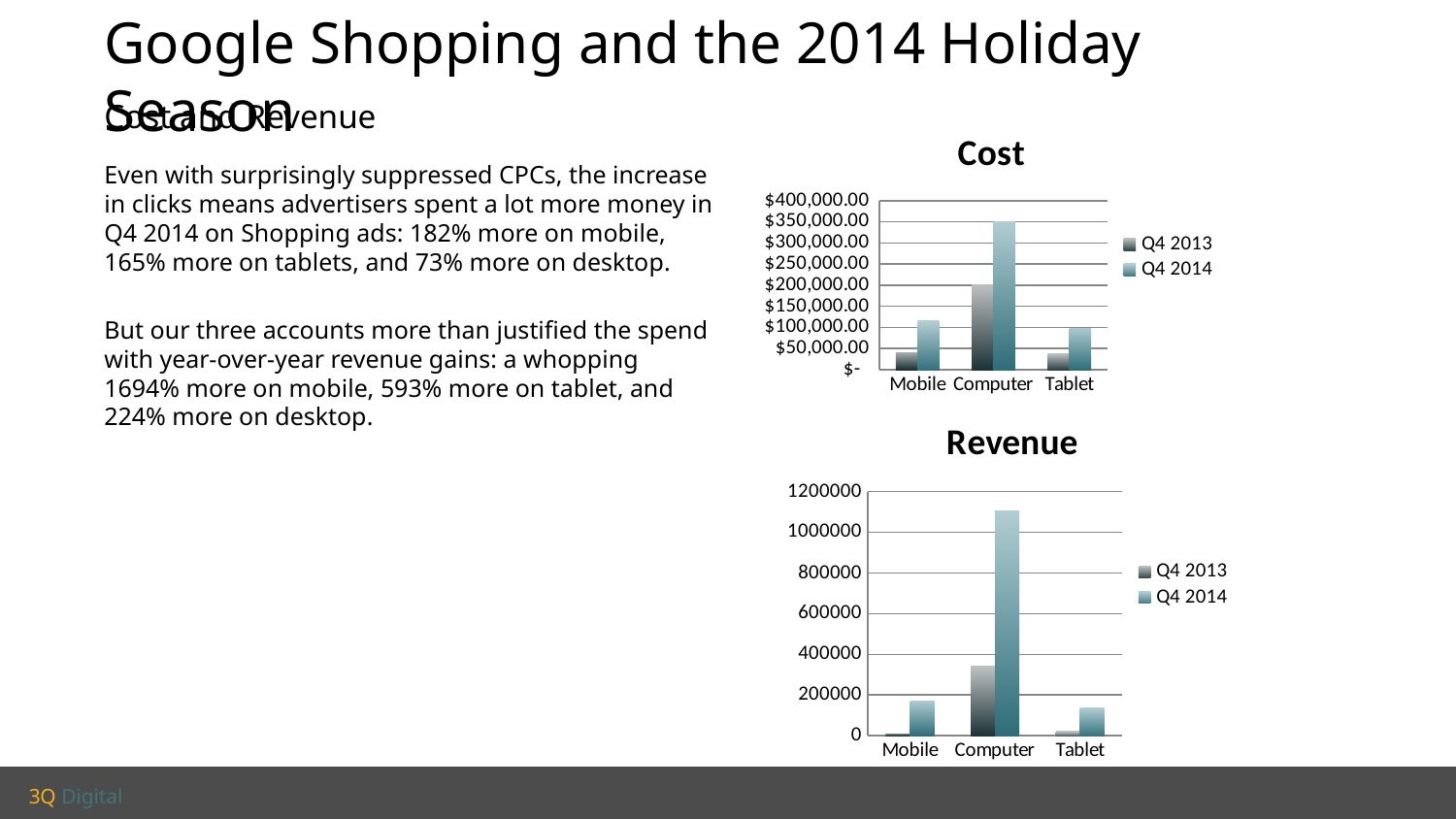
In the Cost chart, is the Q4 2014 cost for Mobile greater or less than $150,000.00? less In the Revenue chart, which category has the highest revenue in Q4 2014? Computer In the Cost chart, is the Q4 2014 cost for Computer greater or less than $300,000.00? greater In the Cost chart, is the Q4 2013 cost for Computer greater or less than $150,000.00? greater How many series does the legend of the Revenue chart list? 2 In the Cost chart, which is larger: the Q4 2014 cost for Mobile or the Q4 2014 cost for Tablet? Mobile In the Cost chart, which category has the highest cost in Q4 2014? Computer In the Revenue chart, which is larger for Tablet: Q4 2013 or Q4 2014? Q4 2014 What kind of chart is the Cost chart? Bar chart